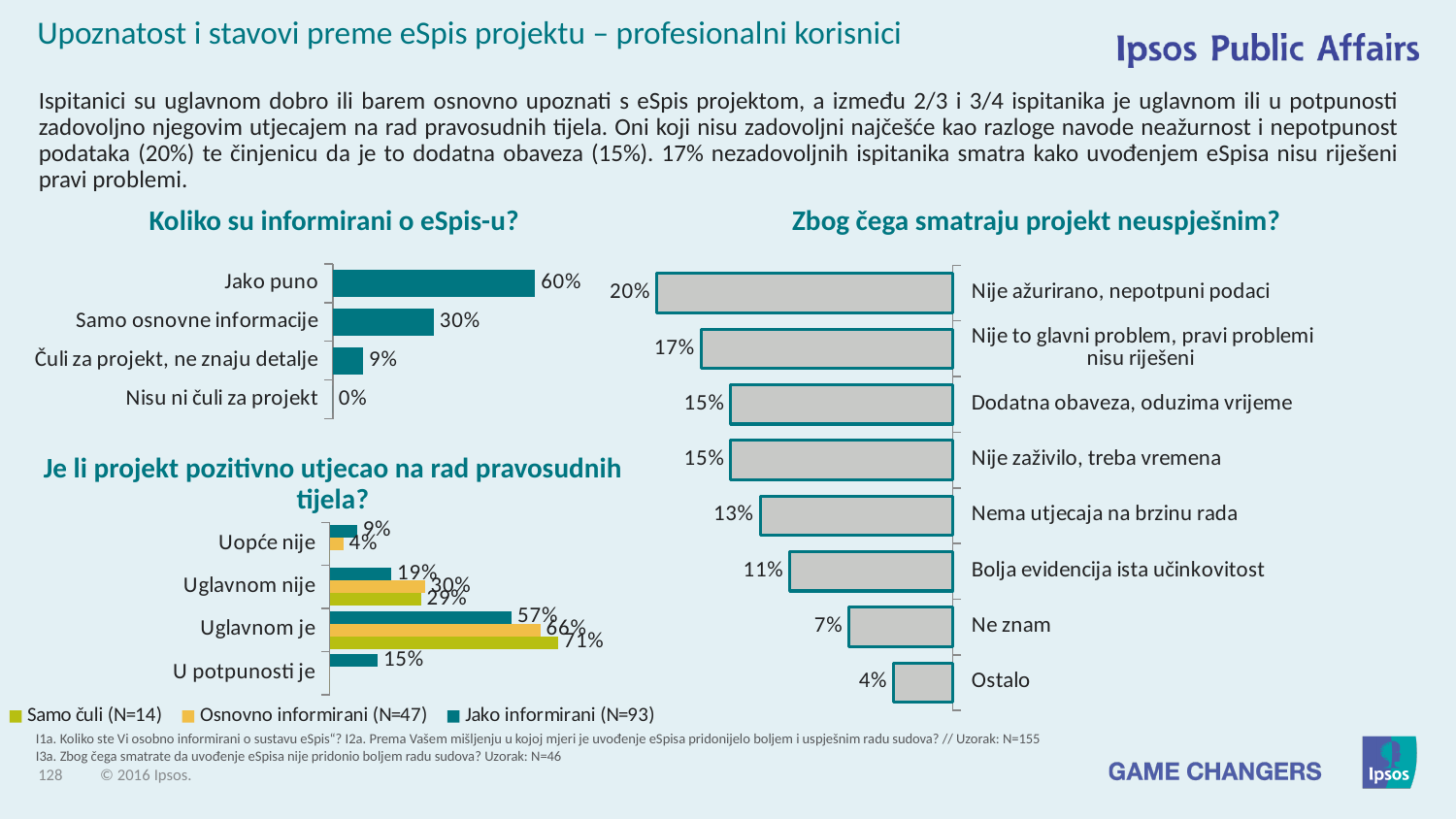
How many categories are shown in the chart 'Zbog čega smatraju projekt neuspješnim?'? 8 In the chart 'Koliko su informirani o eSpis-u?', which category has the lowest value? Nisu ni čuli za projekt How many categories are shown in the chart 'Koliko su informirani o eSpis-u?'? 4 In the chart 'Je li projekt pozitivno utjecao na rad pravosudnih tijela?', what is the value for 'Uglavnom je' in the 'Jako informirani (N=93)' series? 57% In the chart 'Zbog čega smatraju projekt neuspješnim?', what is the value for 'Ne znam'? 7% In the chart 'Koliko su informirani o eSpis-u?', what is the value for 'Samo osnovne informacije'? 30% In the chart 'Zbog čega smatraju projekt neuspješnim?', which category has the highest value? Nije ažurirano, nepotpuni podaci In the chart 'Koliko su informirani o eSpis-u?', what is the value for 'Jako puno'? 60% In the chart 'Zbog čega smatraju projekt neuspješnim?', which is larger: 'Nema utjecaja na brzinu rada' or 'Bolja evidencija ista učinkovitost'? Nema utjecaja na brzinu rada In the chart 'Koliko su informirani o eSpis-u?', what is the difference between 'Jako puno' and 'Samo osnovne informacije'? 30% In the chart 'Zbog čega smatraju projekt neuspješnim?', what is the value for 'Nije ažurirano, nepotpuni podaci'? 20% How many series does the legend list for the chart 'Je li projekt pozitivno utjecao na rad pravosudnih tijela?'? 3